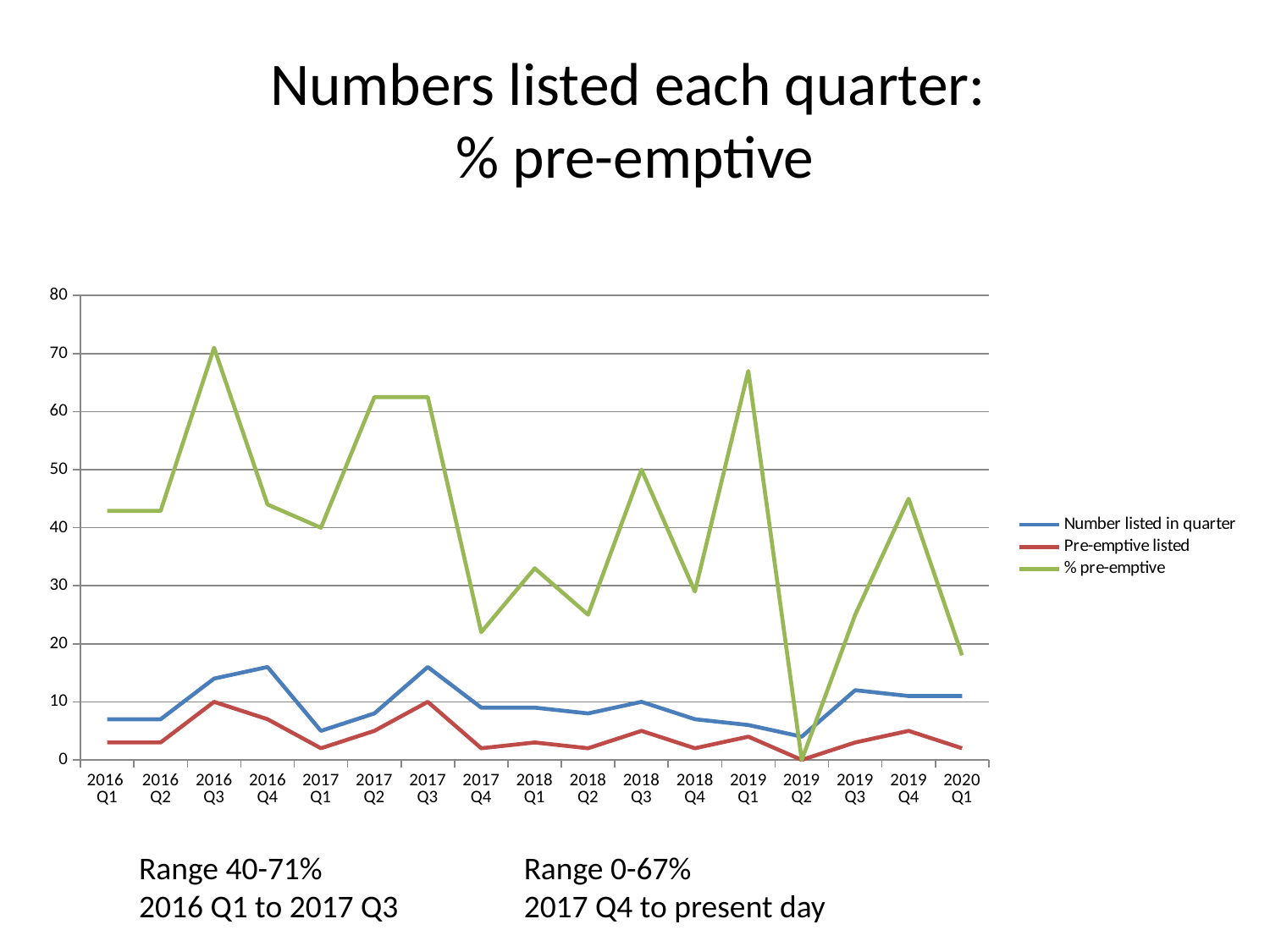
Does the % pre-emptive line rise or fall from 2019 Q4 to 2020 Q1? fall In which quarter is the % pre-emptive line at its highest? 2016 Q3 Which quarter has the larger Number listed in quarter value, 2016 Q4 or 2017 Q1? 2016 Q4 How many series does the legend list? 3 What kind of chart is shown on the slide? line chart Is the % pre-emptive value for 2017 Q4 greater or less than 30? less How many quarters are plotted along the x axis? 17 What is the % pre-emptive value for 2019 Q2? 0 Is the % pre-emptive value for 2019 Q1 greater or less than 60? greater In which quarter is the % pre-emptive line at its lowest? 2019 Q2 What colour is the % pre-emptive line in the legend? green Is the Number listed in quarter value for 2019 Q3 greater or less than 10? greater